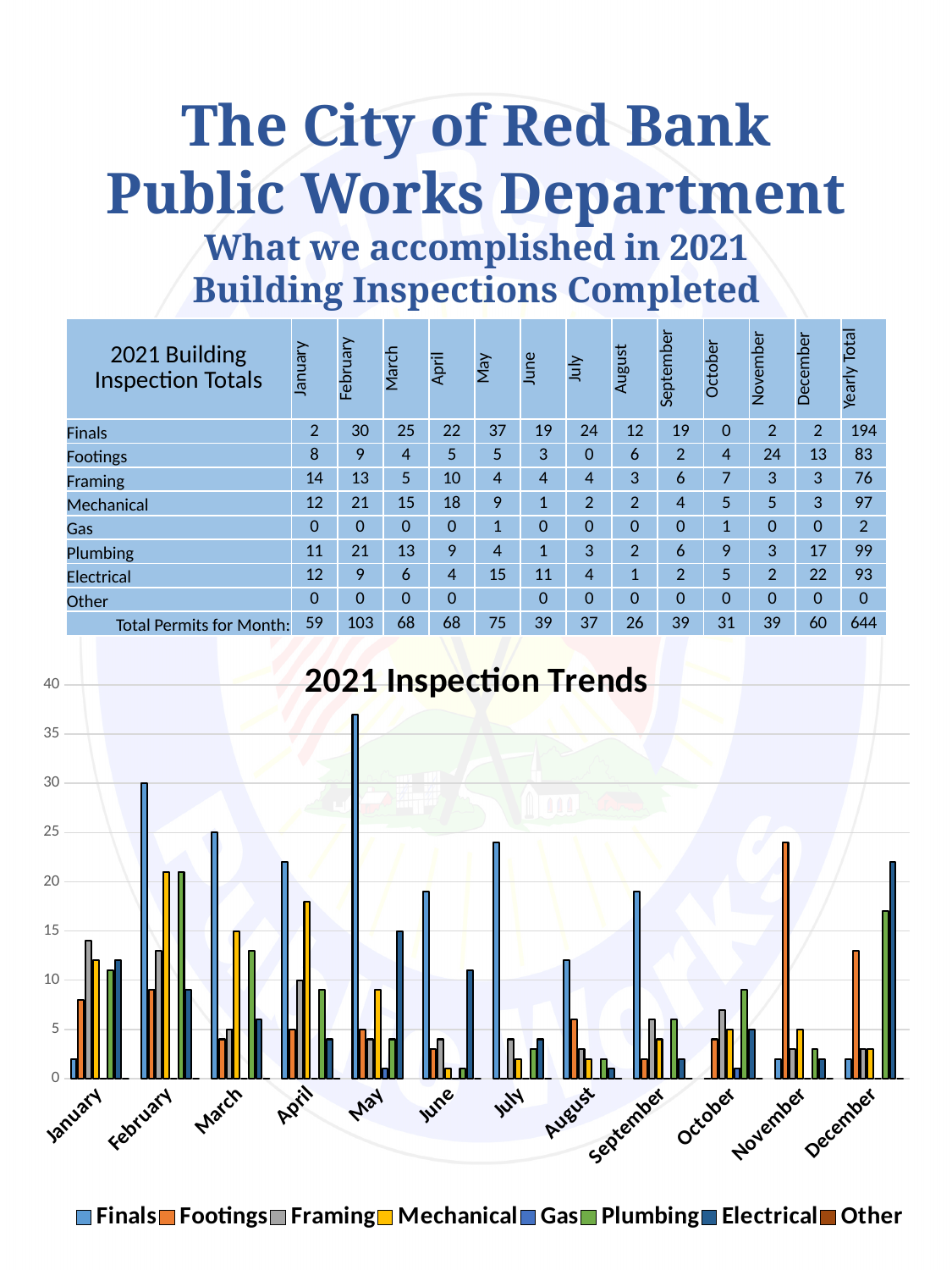
What is the title of the chart on the slide? 2021 Inspection Trends In the 2021 Inspection Trends chart, is the Finals value for February greater or less than 25? greater In the 2021 Inspection Trends chart, which month has the tallest Electrical bar? December In the 2021 Inspection Trends chart, which month has the tallest Finals bar? May In the 2021 Inspection Trends chart, is the Mechanical value for April greater or less than 15? greater In the 2021 Inspection Trends chart, is the Footings value for November greater or less than 20? greater How many series does the legend of the 2021 Inspection Trends chart list? 8 In the 2021 Inspection Trends chart, what is the difference between the Finals value for May and the Finals value for July? 13 What is the Finals value for May in the 2021 Inspection Trends chart? 37 How many months are shown along the x axis of the 2021 Inspection Trends chart? 12 What kind of chart is the 2021 Inspection Trends chart? bar chart In the 2021 Inspection Trends chart, which is larger in December: Electrical or Plumbing? Electrical